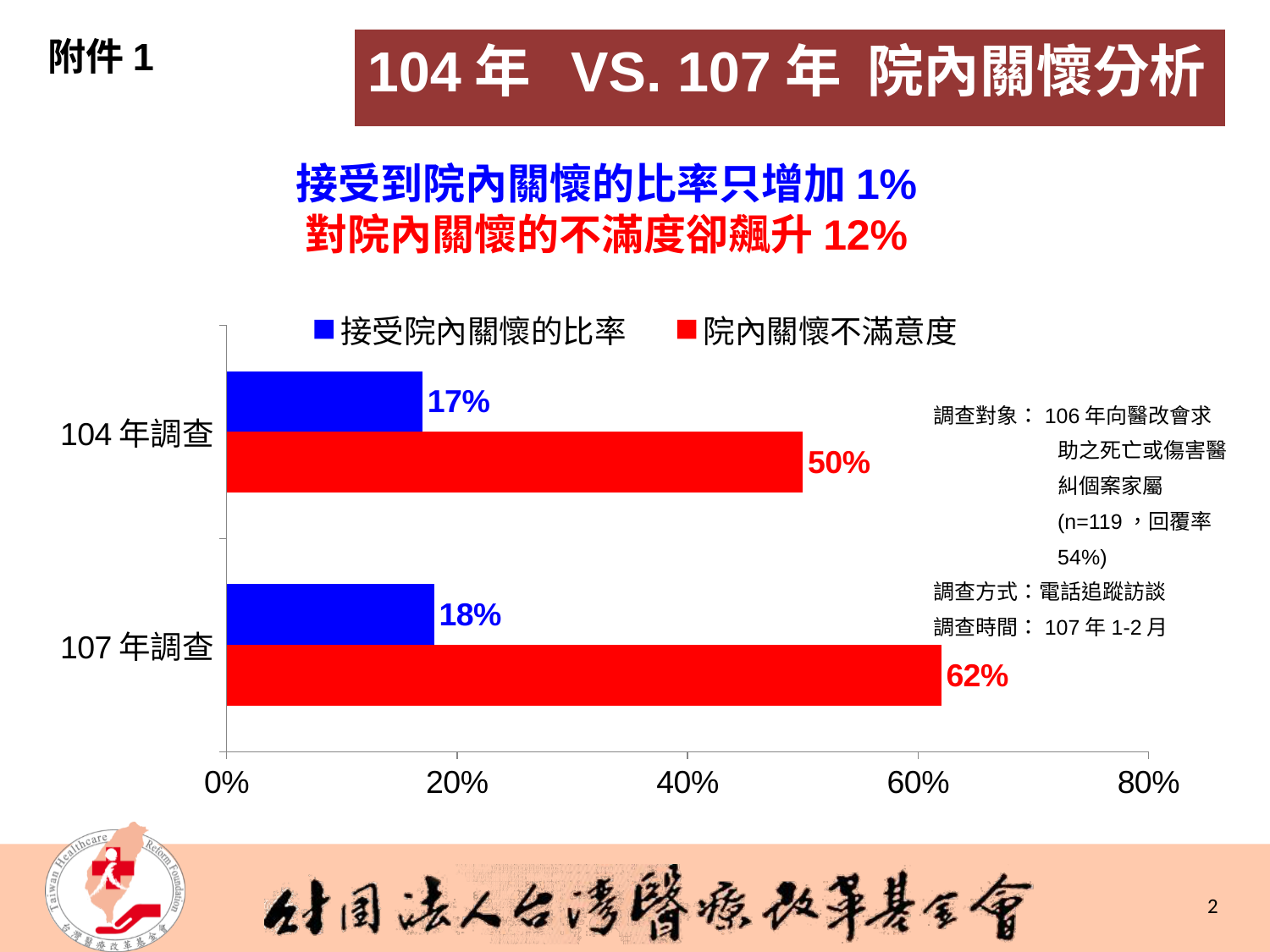
What is the value of 接受院內關懷的比率 for 104年調查? 17% What is the value of 院內關懷不滿意度 for 104年調查? 50% Which is larger for 104年調查: 接受院內關懷的比率 or 院內關懷不滿意度? 院內關懷不滿意度 What is the value of 接受院內關懷的比率 for 107年調查? 18% What is the difference in 接受院內關懷的比率 between 107年調查 and 104年調查? 1% What kind of chart is shown on the slide? bar chart What is the difference in 院內關懷不滿意度 between 107年調查 and 104年調查? 12% Is the value of 院內關懷不滿意度 for 107年調查 greater or less than 60%? greater How many series does the legend list? 2 What is the value of 院內關懷不滿意度 for 107年調查? 62% How many categories are shown on the chart? 2 Which category has the highest 院內關懷不滿意度? 107年調查